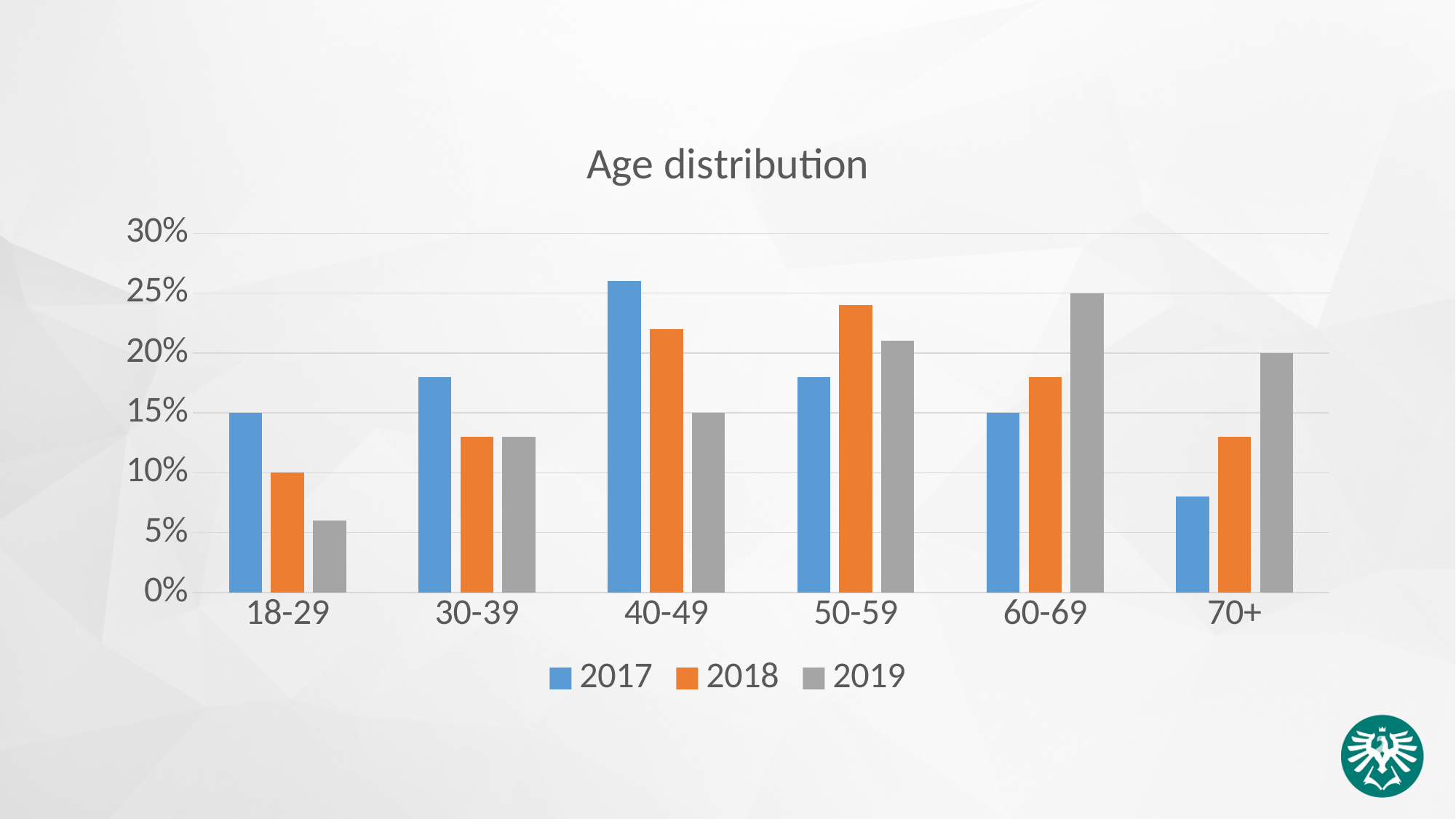
Which age group has the highest value for 2019? 60-69 What kind of chart is shown on the slide? bar chart What is the 2019 value for the 60-69 age group? 25% Which age group has the lowest value for 2019? 18-29 Is the 2017 value for 40-49 greater or less than 25%? greater What is the title of the chart? Age distribution For the 18-29 age group, which is larger: the 2017 value or the 2019 value? 2017 Is the 2018 value for 50-59 greater or less than 20%? greater Is the 2019 value for 18-29 greater or less than 10%? less Which age group has the highest value for 2017? 40-49 How many age groups are shown on the x axis? 6 How many series does the legend list? 3